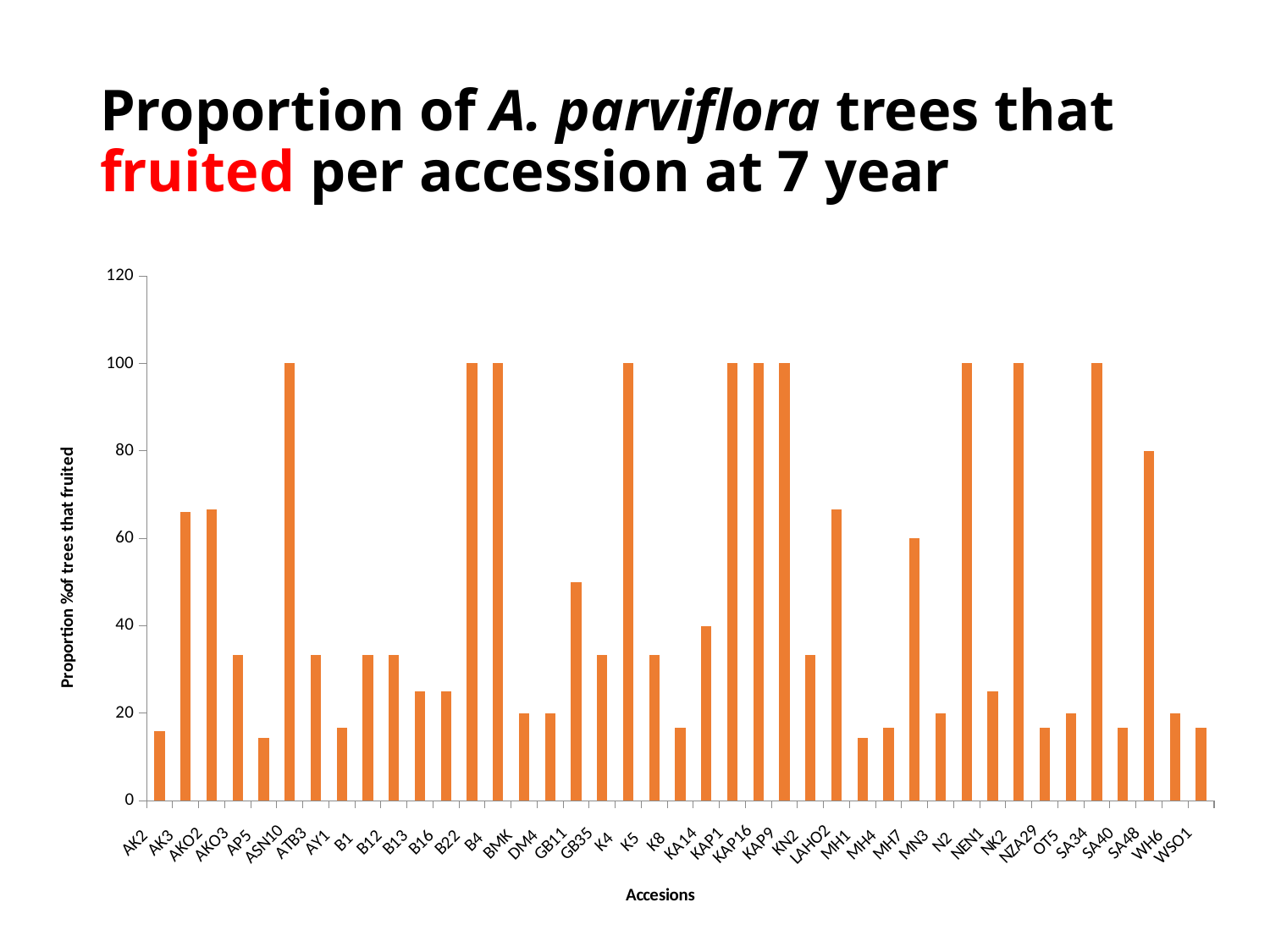
Is the value for AKO2 greater or less than 60? greater What is the value for MN3? 20 Is the value for AK2 greater or less than 20? less How many accessions are plotted along the x axis? 41 What is the highest value reached by any bar in the chart? 100 What is the value for WH6? 20 What kind of chart is shown on the slide? bar chart How many accessions have a value of 100? 10 What is the value for KAP1? 100 Which has the larger value, K5 or K8? K5